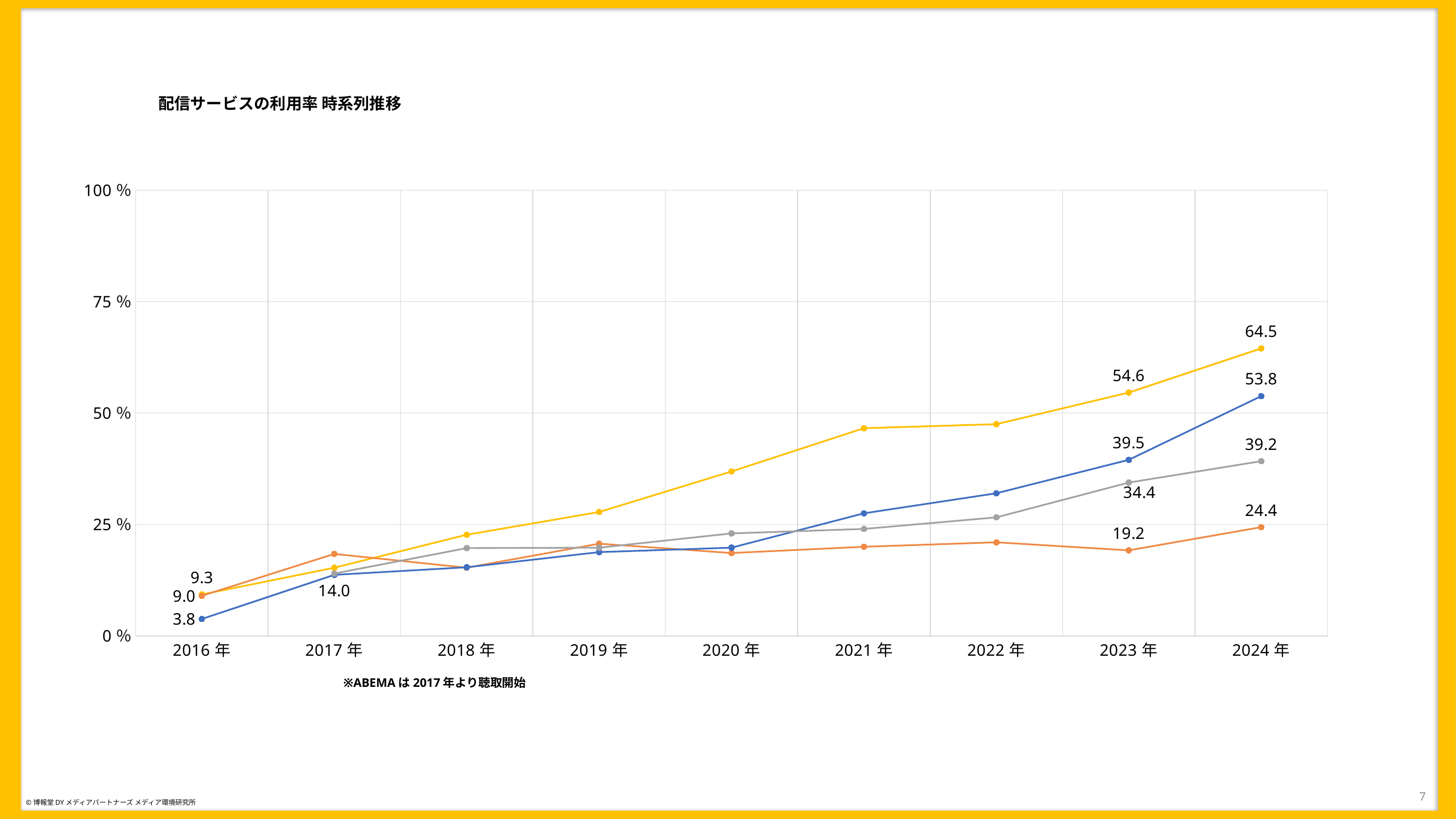
Is the value of the yellow line in 2021年 greater or less than 50%? less Does the blue line rise or fall from 2016年 to 2024年? rises How many years are shown on the x axis of the chart? 9 What is the value of the yellow line in 2024年? 64.5 What kind of chart is shown on the slide? line chart What is the title of the chart? 配信サービスの利用率 時系列推移 What is the value of the blue line in 2023年? 39.5 What is the value of the orange line in 2016年? 9.0 What is the difference between the yellow line's values in 2024年 and 2023年? 9.9 Which line has the lowest value in 2016年? the blue line Which line has the highest value in 2024年? the yellow line What is the value of the gray line in 2017年? 14.0